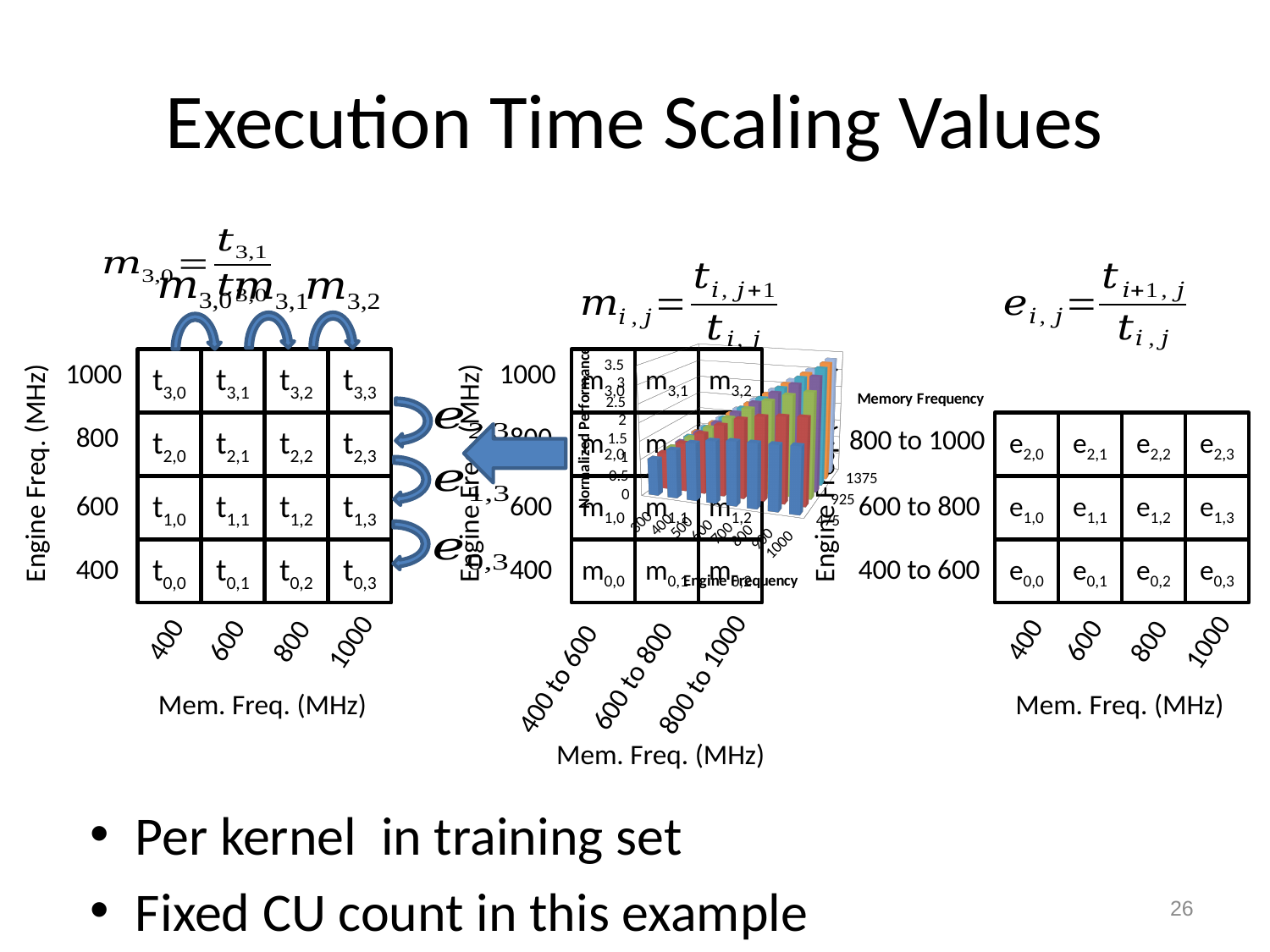
What kind of chart is overlaid on the middle table of the slide? 3D bar chart How many engine frequency categories are shown along the horizontal axis of the 3D bar chart? 8 In the 3D bar chart, do the bar heights generally rise or fall as engine frequency increases along the horizontal axis? rise What is the title of the horizontal axis of the 3D bar chart? Engine Frequency What is the highest tick value shown on the vertical axis of the 3D bar chart? 3.5 What is the title of the vertical axis of the 3D bar chart? Normalized Performance